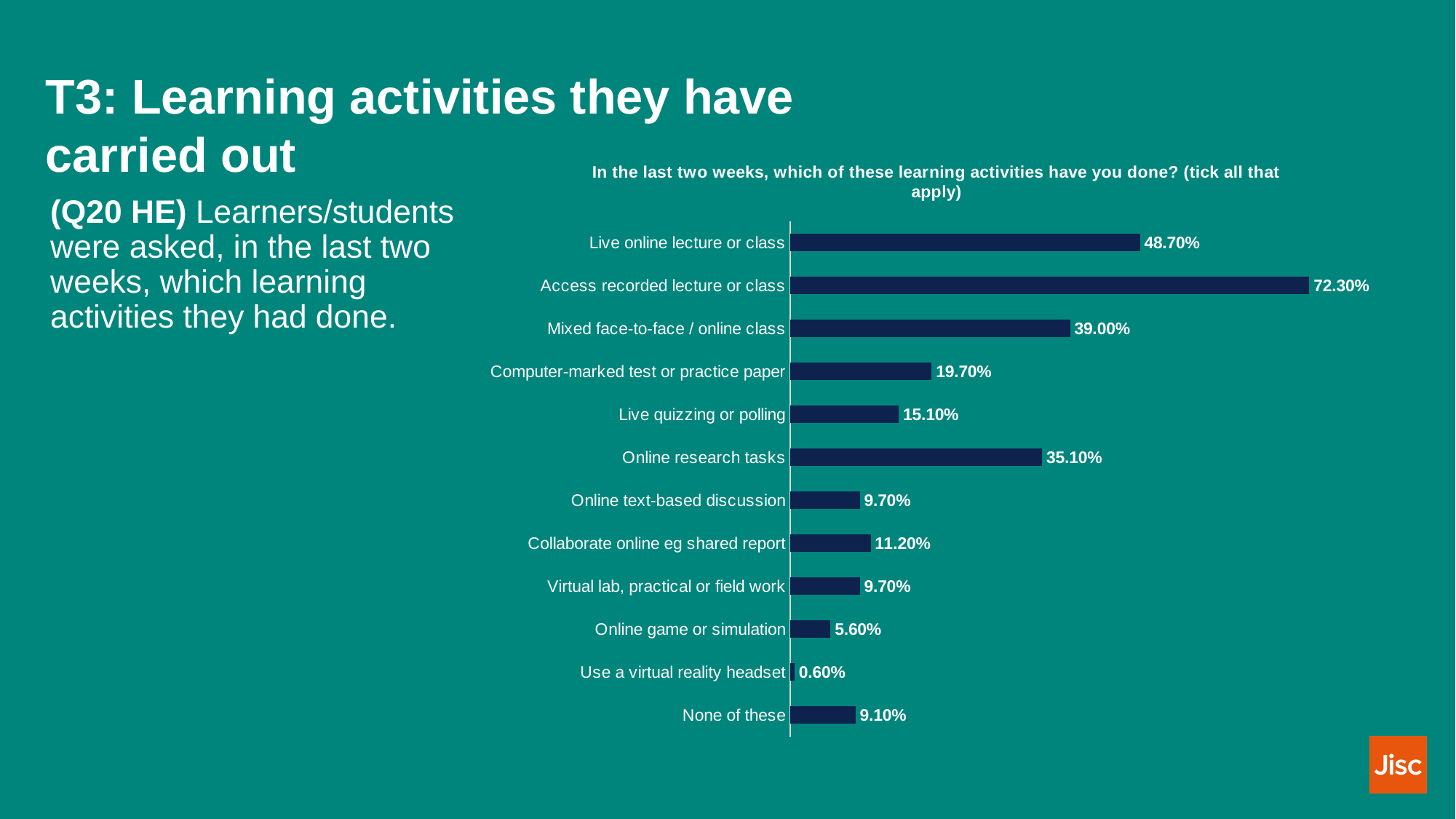
What is the difference between 'Access recorded lecture or class' and 'Live online lecture or class'? 23.60% How many learning activity categories are shown in the chart? 12 What is the title of the chart? In the last two weeks, which of these learning activities have you done? (tick all that apply) What percentage of students used a virtual reality headset? 0.60% What is the value for 'None of these'? 9.10% What percentage of students reported doing a live online lecture or class? 48.70% Which learning activity has the lowest percentage? Use a virtual reality headset Which learning activity has the highest percentage? Access recorded lecture or class What is the difference between 'Computer-marked test or practice paper' and 'Live quizzing or polling'? 4.60% Which is larger: 'Mixed face-to-face / online class' or 'Online research tasks'? Mixed face-to-face / online class What type of chart is shown on the slide? Bar chart What is the value for 'Online research tasks'? 35.10%